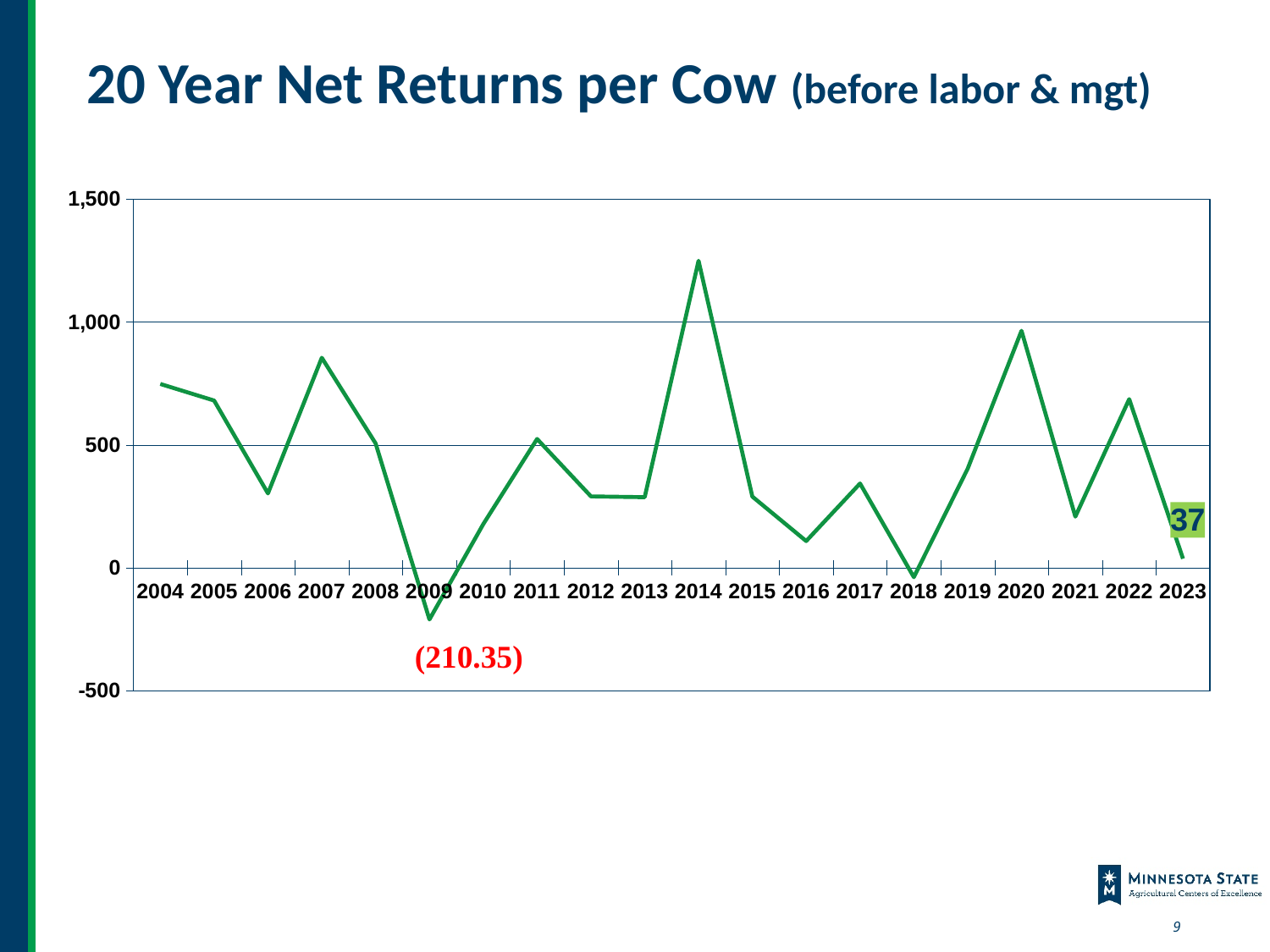
What is the title of the chart on the slide? 20 Year Net Returns per Cow (before labor & mgt) Which year has the larger net return per cow, 2014 or 2020? 2014 Is the value for 2007 greater or less than 500? greater Is the value for 2006 greater or less than 500? less What value is labeled on the chart for 2009? (210.35) How many years are plotted on the x axis? 20 Do the values rise or fall from 2018 to 2020? rise Which year has the lowest net return per cow? 2009 Is the value for 2014 greater or less than 1,000? greater What is the net return per cow shown for 2023? 37 Which year has the highest net return per cow? 2014 What type of chart is shown on the slide? line chart